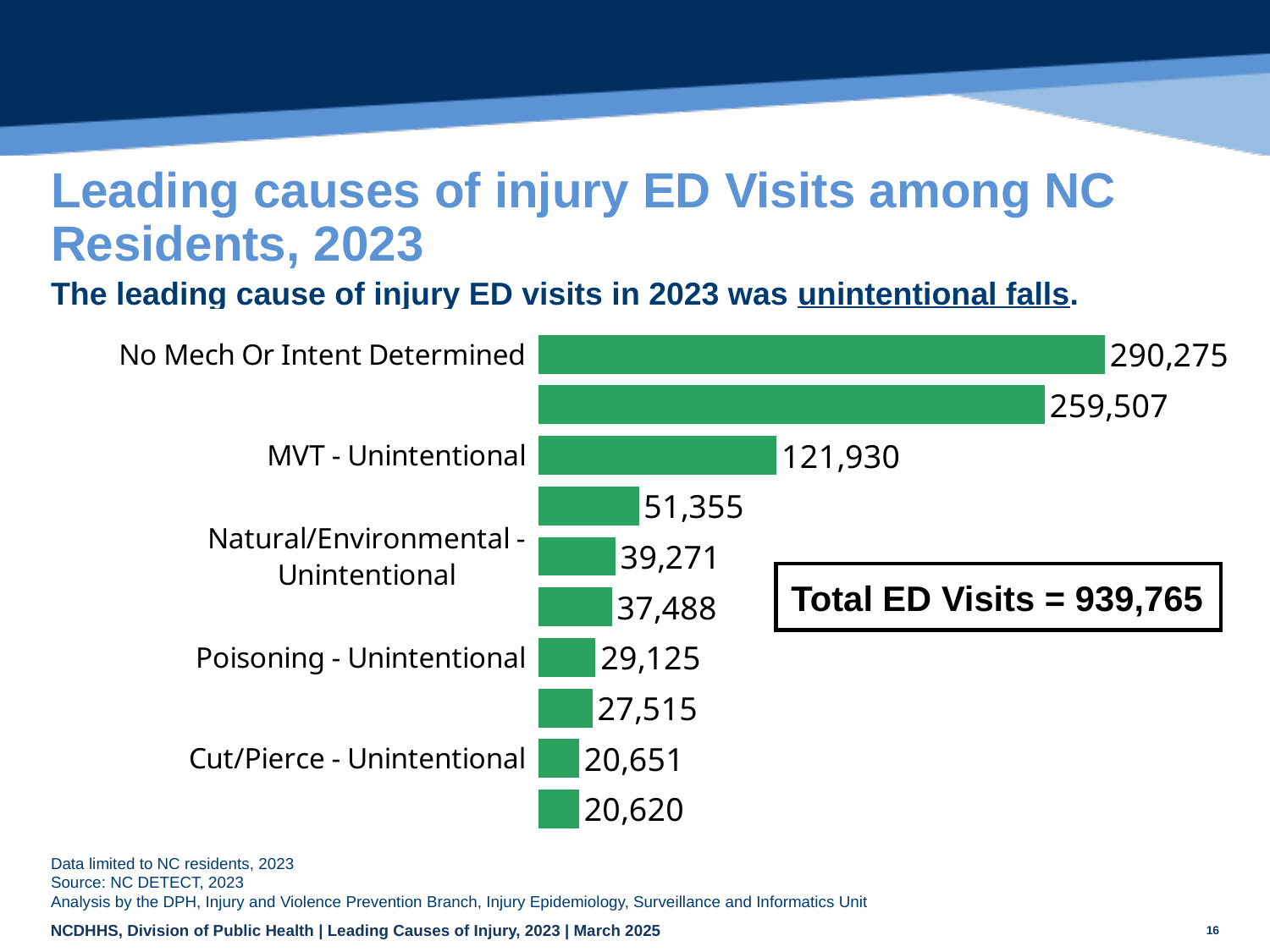
What is the value for Natural/Environmental - Unintentional? 39,271 Which is larger, MVT - Unintentional or Poisoning - Unintentional? MVT - Unintentional What is the difference between No Mech Or Intent Determined and MVT - Unintentional? 168,345 What kind of chart is shown on the slide? Bar chart What is the value for Poisoning - Unintentional? 29,125 What is the value for Cut/Pierce - Unintentional? 20,651 What is the difference between Poisoning - Unintentional and Cut/Pierce - Unintentional? 8,474 What is the value for MVT - Unintentional? 121,930 How many bars are shown on the chart? 10 What is the smallest value shown on the chart? 20,620 Which category has the highest value? No Mech Or Intent Determined What is the value for No Mech Or Intent Determined? 290,275